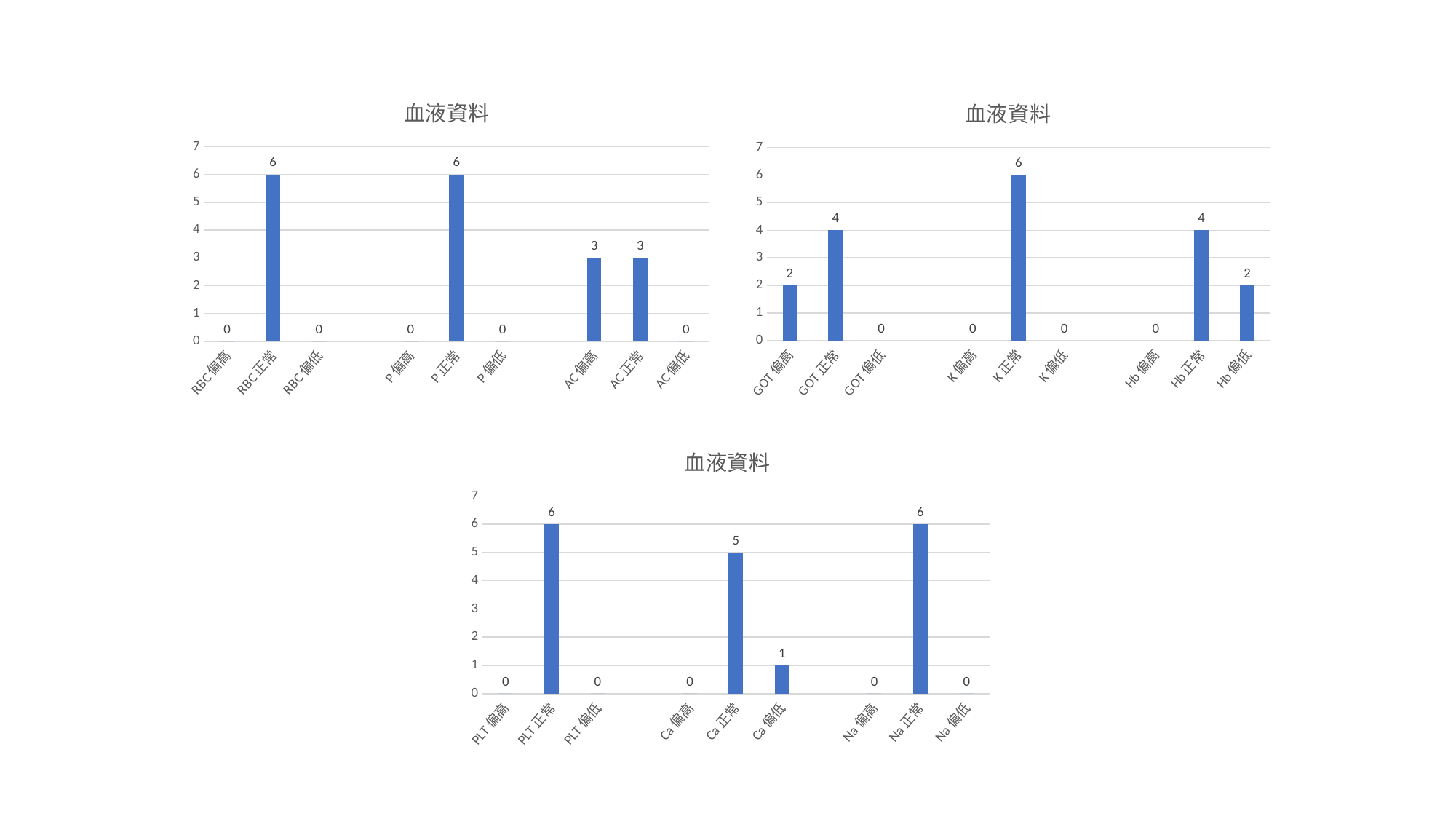
In the top-right chart, what is the value for GOT 偏高? 2 How many categories are shown on the x axis of the top-left chart? 9 In the bottom chart, what is the value for Ca 偏低? 1 In the bottom chart, what is the value for Ca 正常? 5 In the top-right chart, what is the difference between Hb 正常 and Hb 偏低? 2 In the top-right chart, which category has the highest value? K 正常 In the top-left chart, what is the value for RBC 正常? 6 What is the title of the top-right chart? 血液資料 In the bottom chart, what is the difference between Ca 正常 and Ca 偏低? 4 What kind of chart is the bottom chart? Bar chart In the top-left chart, what is the value for AC 偏高? 3 In the bottom chart, which is larger, PLT 正常 or Ca 正常? PLT 正常